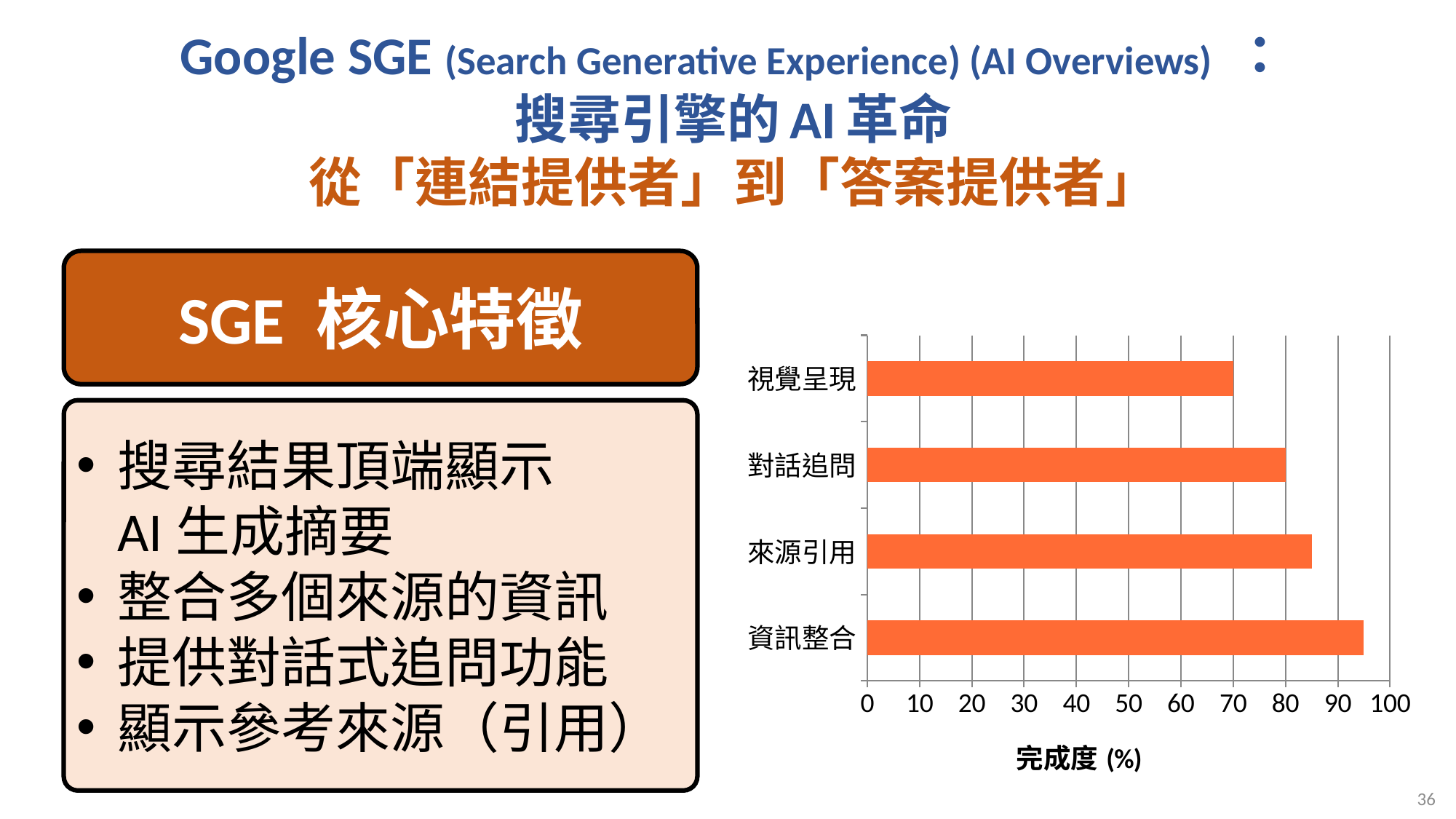
What is the value for 對話追問 in the bar chart? 80 How many categories are plotted in the bar chart? 4 What is the difference between the values for 對話追問 and 視覺呈現? 10 Is the value for 來源引用 greater or less than 80? greater Which category has the highest value in the bar chart? 資訊整合 Which category has the lowest value in the bar chart? 視覺呈現 What is the title of the horizontal axis of the bar chart? 完成度 (%) Which is larger, the value for 來源引用 or the value for 對話追問? 來源引用 What is the maximum value shown on the horizontal axis of the bar chart? 100 What kind of chart is shown on the slide? bar chart What is the value for 視覺呈現 in the bar chart? 70 Is the value for 資訊整合 greater or less than 90? greater